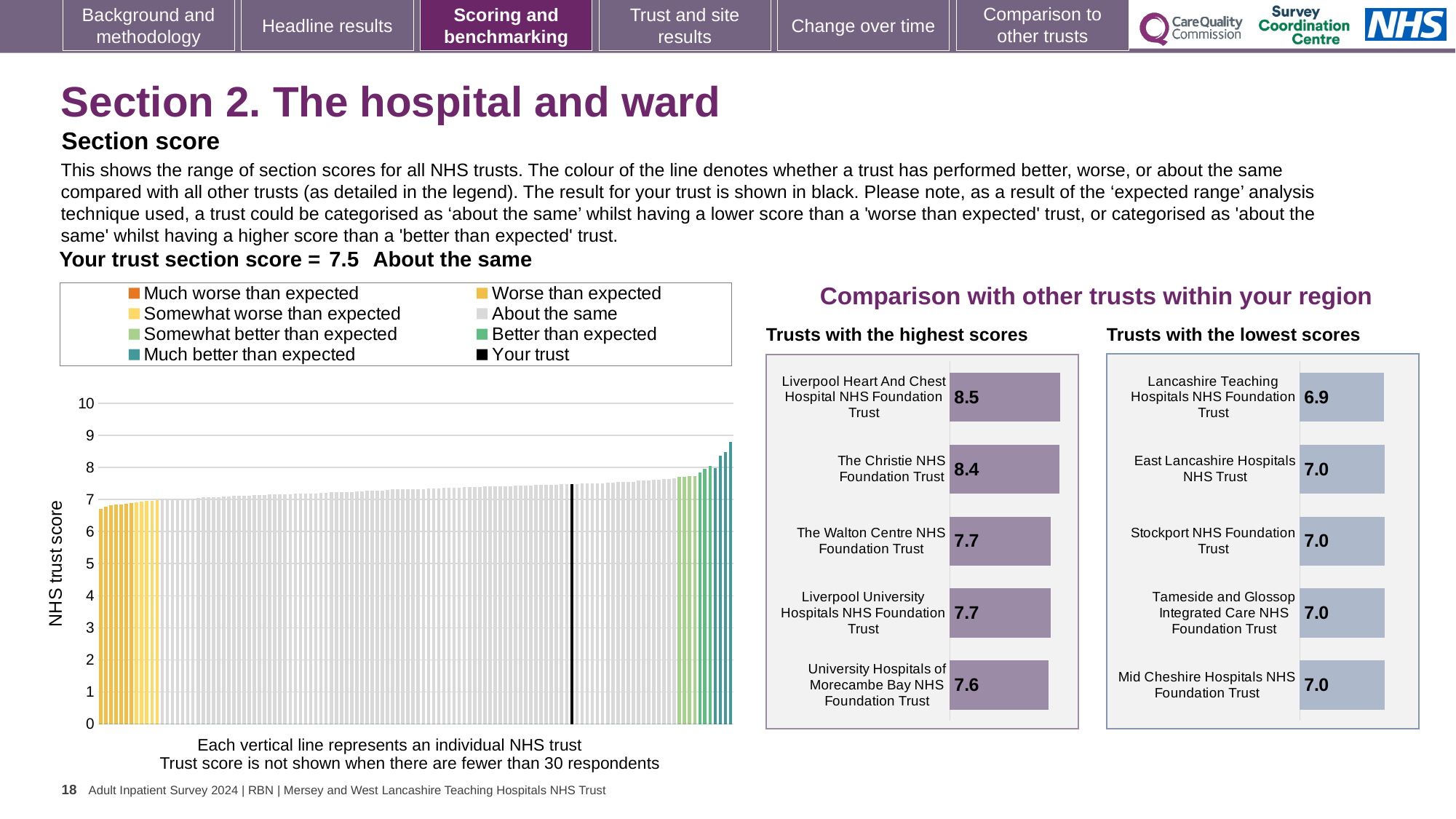
In the 'Trusts with the highest scores' chart, which trust has the highest score? Liverpool Heart And Chest Hospital NHS Foundation Trust In the 'Trusts with the highest scores' chart, what is the difference between the scores of Liverpool Heart And Chest Hospital NHS Foundation Trust and University Hospitals of Morecambe Bay NHS Foundation Trust? 0.9 In the 'Trusts with the highest scores' chart, which has the larger score: The Christie NHS Foundation Trust or The Walton Centre NHS Foundation Trust? The Christie NHS Foundation Trust In the 'Trusts with the lowest scores' chart, what is the score for Lancashire Teaching Hospitals NHS Foundation Trust? 6.9 In the 'Trusts with the lowest scores' chart, which trust has the lowest score? Lancashire Teaching Hospitals NHS Foundation Trust How many entries does the legend of the main 'NHS trust score' chart on the left list? 8 How many trusts are shown in the 'Trusts with the lowest scores' chart? 5 In the main 'NHS trust score' chart on the left, what is your trust's section score as stated on the slide? 7.5 What kind of chart is the main 'NHS trust score' chart on the left? bar chart In the main 'NHS trust score' chart on the left, do the values rise or fall from left to right? rise In the 'Trusts with the highest scores' chart, what is the score for The Christie NHS Foundation Trust? 8.4 In the 'Trusts with the highest scores' chart, what is the score for Liverpool Heart And Chest Hospital NHS Foundation Trust? 8.5